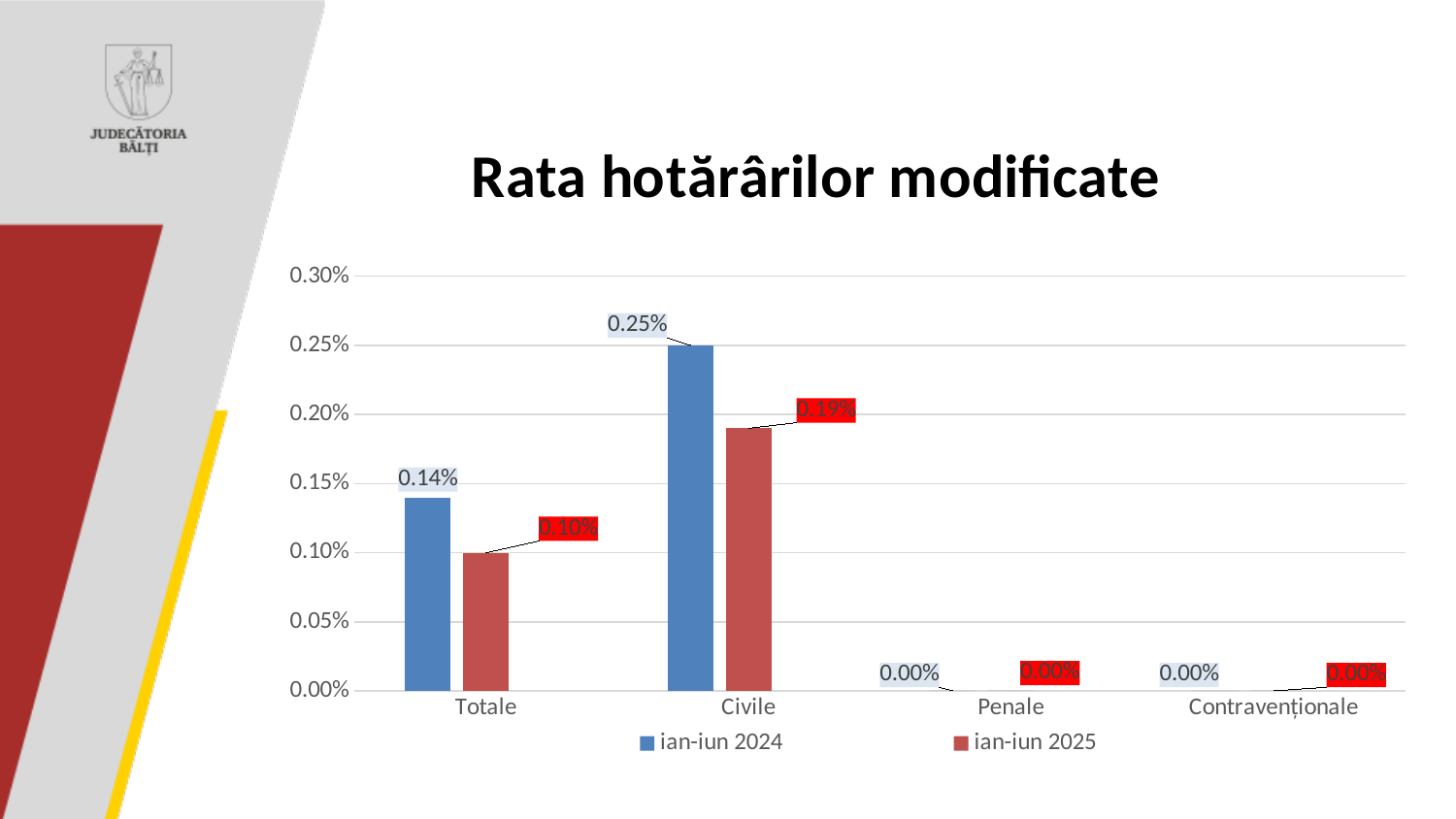
What is the value for Penale in the ian-iun 2024 series? 0.00% What is the value for Civile in the ian-iun 2025 series? 0.19% How many categories are shown on the x axis? 4 Which is larger for Totale: the ian-iun 2024 value or the ian-iun 2025 value? ian-iun 2024 What is the value for Civile in the ian-iun 2024 series? 0.25% What is the title of the chart? Rata hotărârilor modificate What is the value for Totale in the ian-iun 2025 series? 0.10% What is the difference between the ian-iun 2024 and ian-iun 2025 values for Totale? 0.04% Which category has the highest value in the ian-iun 2024 series? Civile How many series does the legend list? 2 What kind of chart is shown on the slide? Bar chart What is the difference between the ian-iun 2024 and ian-iun 2025 values for Civile? 0.06%